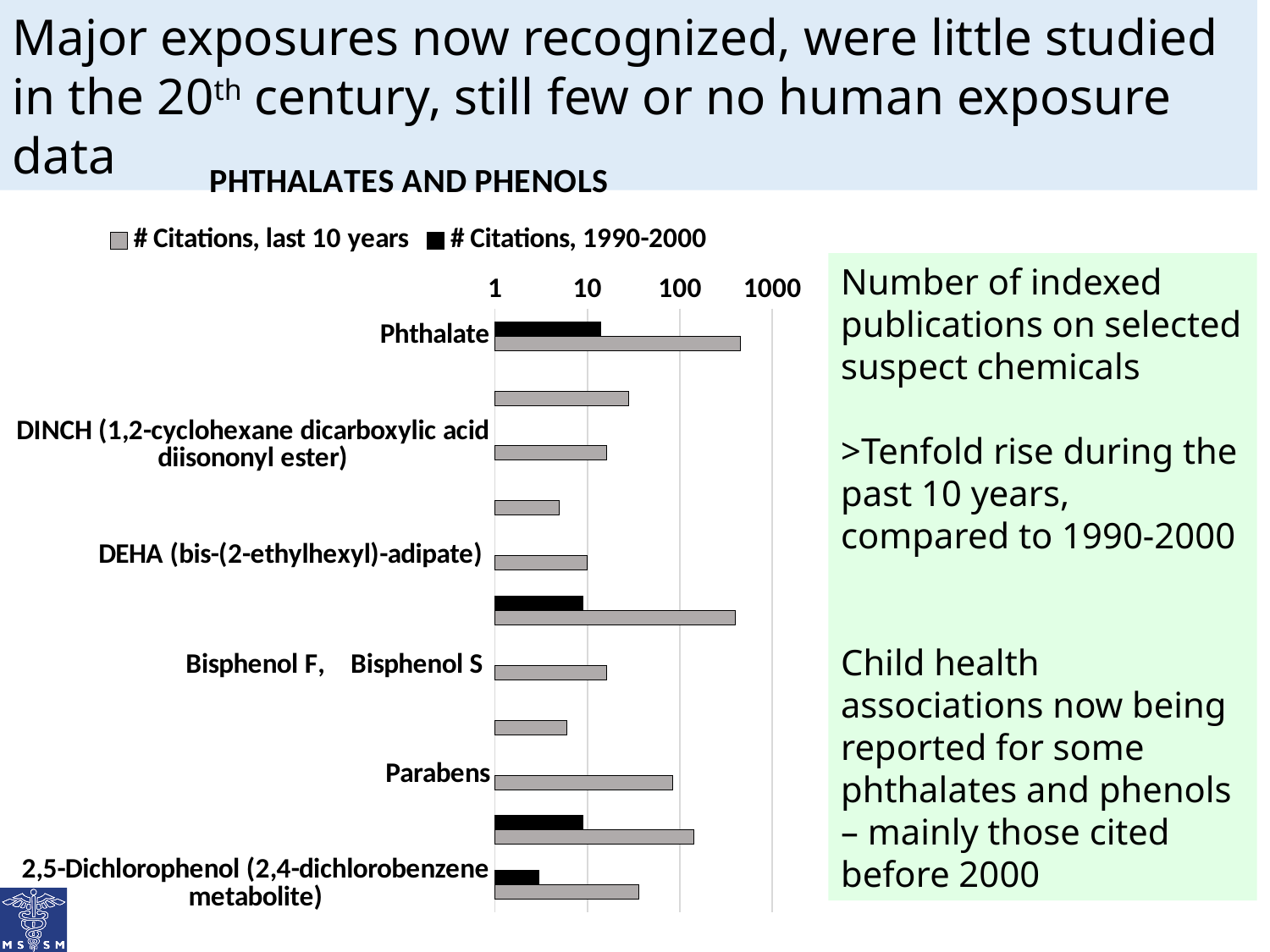
Is the value for 2,5-Dichlorophenol in the '# Citations, 1990-2000' series greater or less than 10? less For Phthalate, which series has the larger value: '# Citations, last 10 years' or '# Citations, 1990-2000'? # Citations, last 10 years What are the two series named in the chart legend? # Citations, last 10 years; # Citations, 1990-2000 Is the value for 2,5-Dichlorophenol in the '# Citations, last 10 years' series greater or less than 10? greater What is the title of the chart? PHTHALATES AND PHENOLS Is the value for Phthalate in the '# Citations, 1990-2000' series greater or less than 100? less How many series does the chart legend list? 2 Which series is shown in black in the chart? # Citations, 1990-2000 What kind of chart is shown on the slide? bar chart